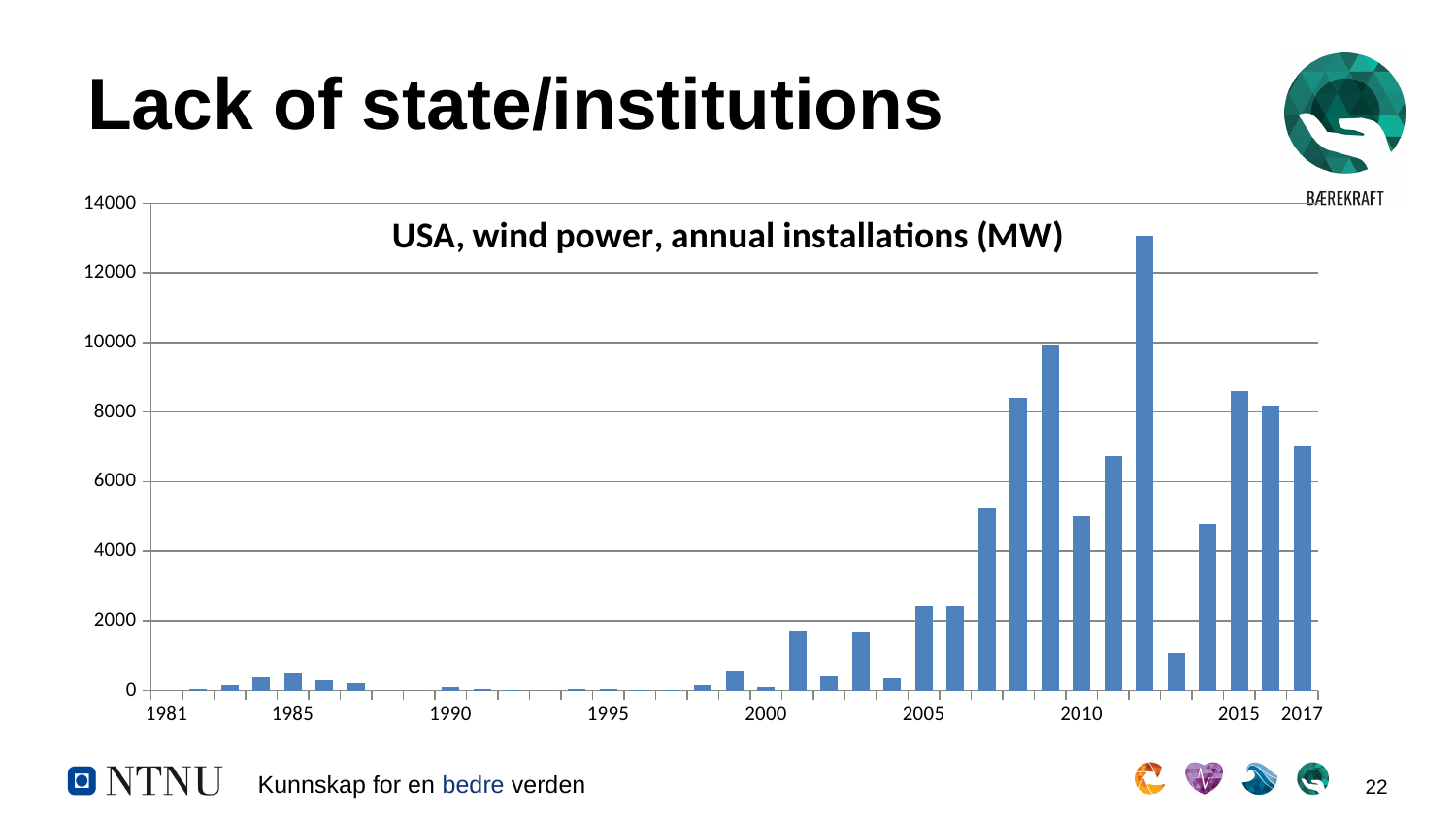
Is the value for 2010 greater or less than 4000? greater Which year has the larger value, 2008 or 2010? 2008 Is the value for 2017 greater or less than 6000? greater What is the title of the chart? USA, wind power, annual installations (MW) Which year has the larger value, 2013 or 2014? 2014 Which year has the highest annual wind power installations in the chart? 2012 Is the value for 2008 greater or less than 8000? greater What kind of chart is shown on the slide? bar chart How many years (bars) are plotted in the chart? 37 What is the highest value shown on the vertical axis? 14000